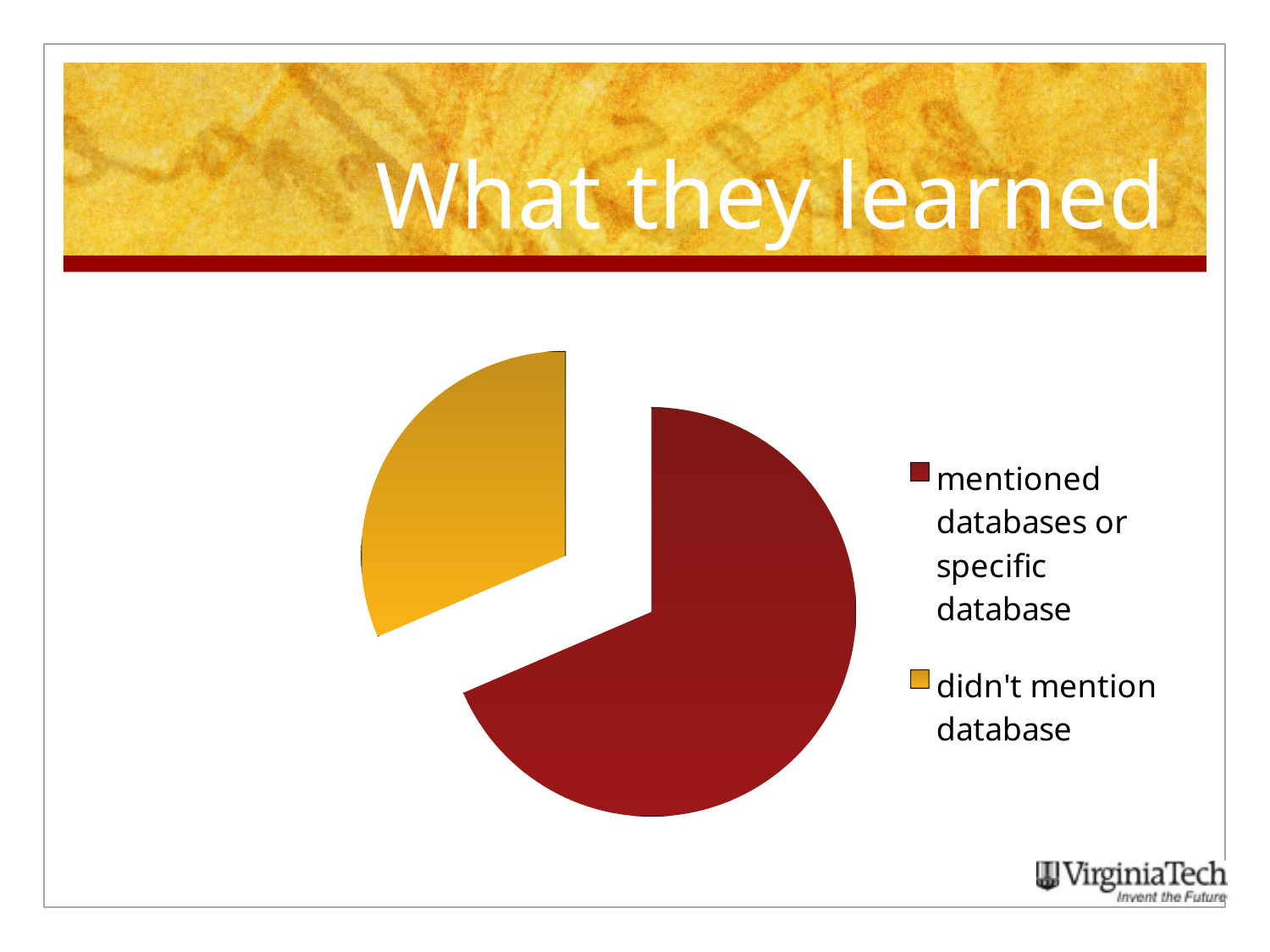
What is the title of the slide containing the pie chart? What they learned Does the "didn't mention database" slice cover more or less than half of the pie? less Which category takes up the largest share of the pie chart? mentioned databases or specific database What colour is the "didn't mention database" slice in the pie chart? yellow Which category takes up the smallest share of the pie chart? didn't mention database What kind of chart is shown on the slide? pie chart How many entries does the legend of the pie chart list? 2 How many slices does the pie chart have? 2 Which slice is larger: "mentioned databases or specific database" or "didn't mention database"? mentioned databases or specific database